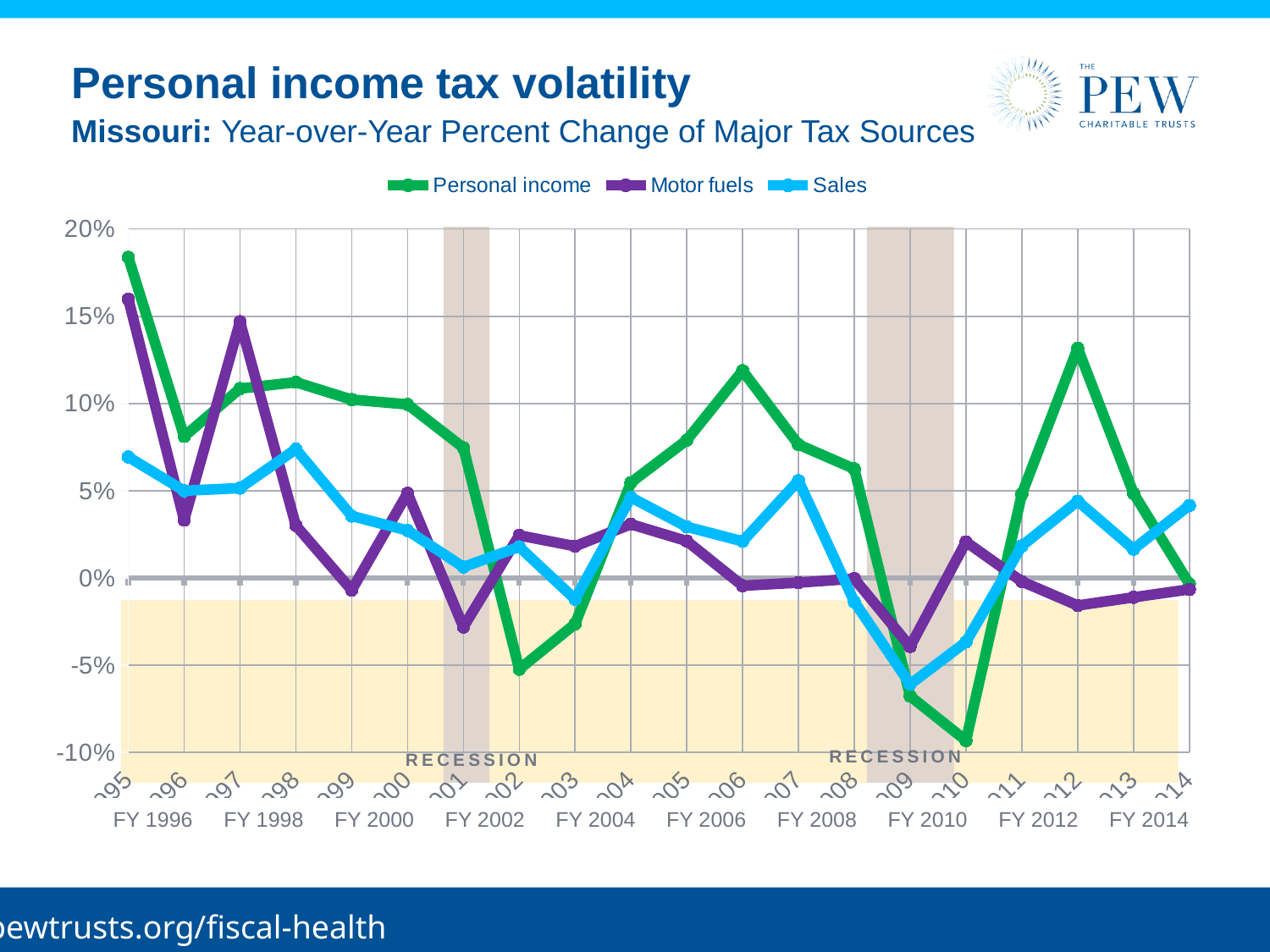
Is the Personal income value for FY 2010 greater or less than -5%? less Is the Personal income value for FY 2012 greater or less than 10%? greater How many series does the legend list? 3 Is the Motor fuels value for FY 1997 greater or less than 10%? greater What kind of chart is shown on the slide? Line chart In FY 2012, which is larger: the Personal income value or the Sales value? Personal income Which tax sources are listed in the chart legend? Personal income, Motor fuels, Sales Which colour is used for the Personal income line? Green In which fiscal year does the Personal income line reach its lowest value? FY 2010 In which fiscal year does the Personal income line reach its highest value? FY 1995 Does the Personal income line rise or fall from FY 2012 to FY 2014? Fall